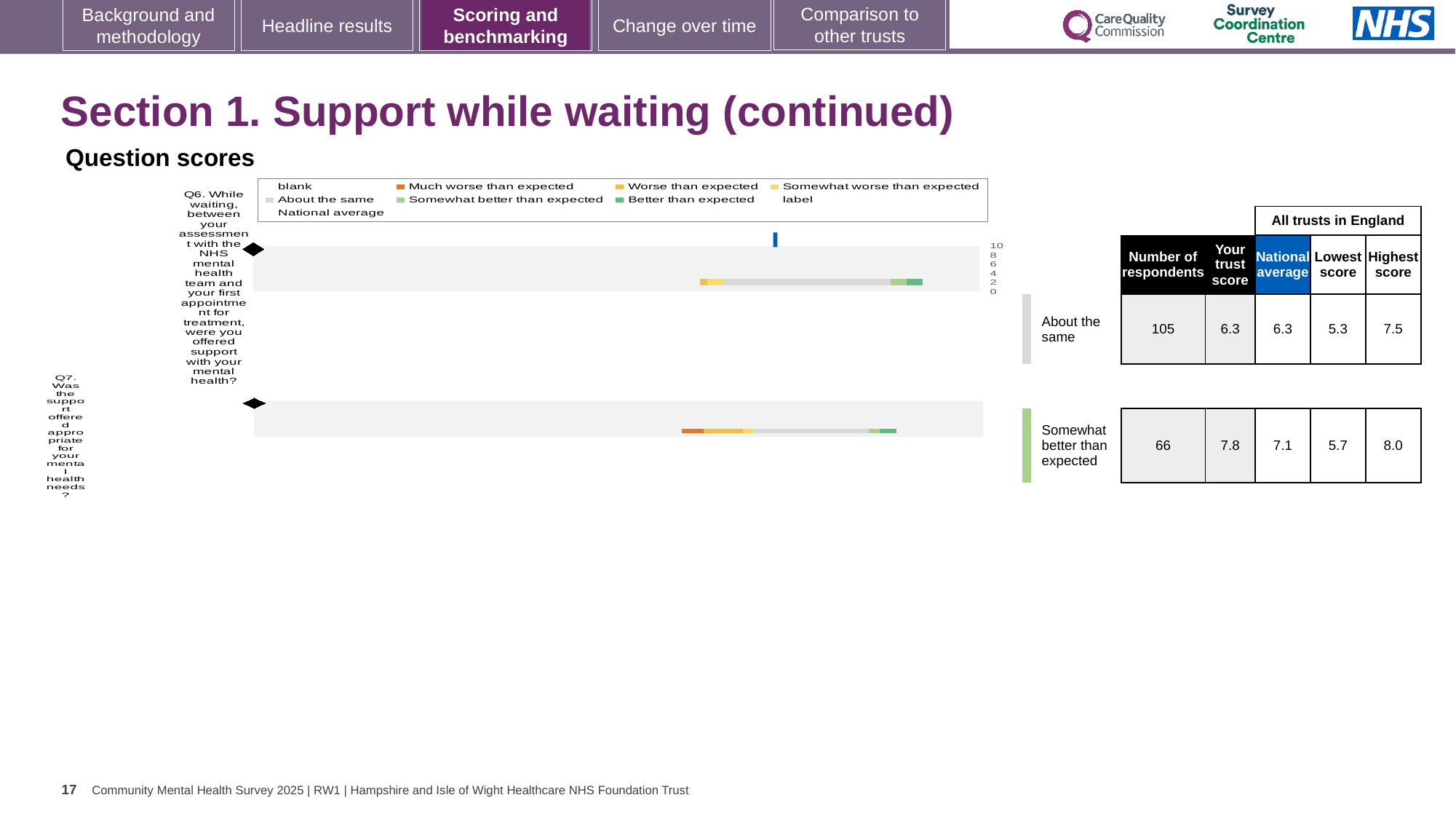
What is the trust score for Q6 (support with mental health while waiting)? 6.3 What is the lowest score among all trusts in England for Q7? 5.7 By how much does the trust score for Q7 exceed the national average for Q7? 0.7 What kind of chart is used to show the question scores? Bar chart How many respondents answered Q7? 66 What is the trust score for Q7 (was the support offered appropriate)? 7.8 Which question has the higher trust score, Q6 or Q7? Q7 How many questions are plotted on the slide? 2 What is the highest score among all trusts in England for Q6? 7.5 How many respondents answered Q6? 105 What benchmark category is the trust's Q7 score placed in? Somewhat better than expected What is the national average score for Q7? 7.1